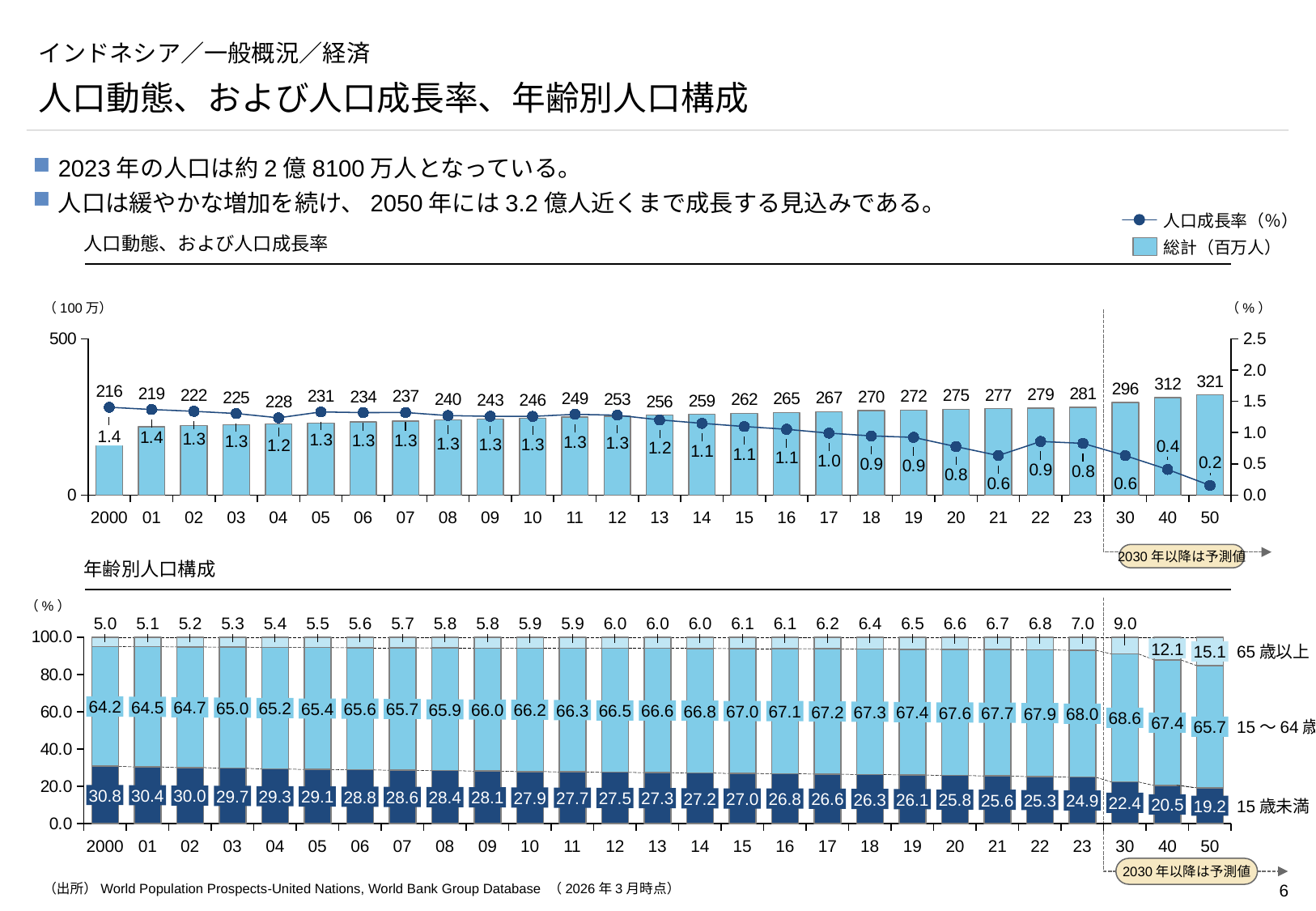
In the bottom chart (年齢別人口構成), what is the share (%) of 65歳以上 in 2050? 15.1 According to the note on the top chart (人口動態、および人口成長率), from which year onward are the values forecasts (予測値)? 2030年 In the bottom chart (年齢別人口構成), what is the difference between the 15～64歳 share in 2023 and in 2000 (percentage points)? 3.8 What kind of chart is the bottom chart (年齢別人口構成)? stacked bar chart In the top chart (人口動態、および人口成長率), what is the total population (百万人) shown for 2023? 281 In the bottom chart (年齢別人口構成), what is the share (%) of 15歳未満 in 2000? 30.8 In the top chart (人口動態、および人口成長率), by how much does the total population in 2050 exceed that in 2000 (百万人)? 105 In the top chart (人口動態、および人口成長率), which year has the highest total population? 2050 In the bottom chart (年齢別人口構成), is the share of 15歳未満 larger in 2000 or in 2050? 2000 In the top chart (人口動態、および人口成長率), what is the population growth rate (%) shown for 2050? 0.2 How many series does the legend of the top chart (人口動態、および人口成長率) list? 2 In the top chart (人口動態、および人口成長率), does the population growth rate line generally rise or fall from 2000 to 2050? fall